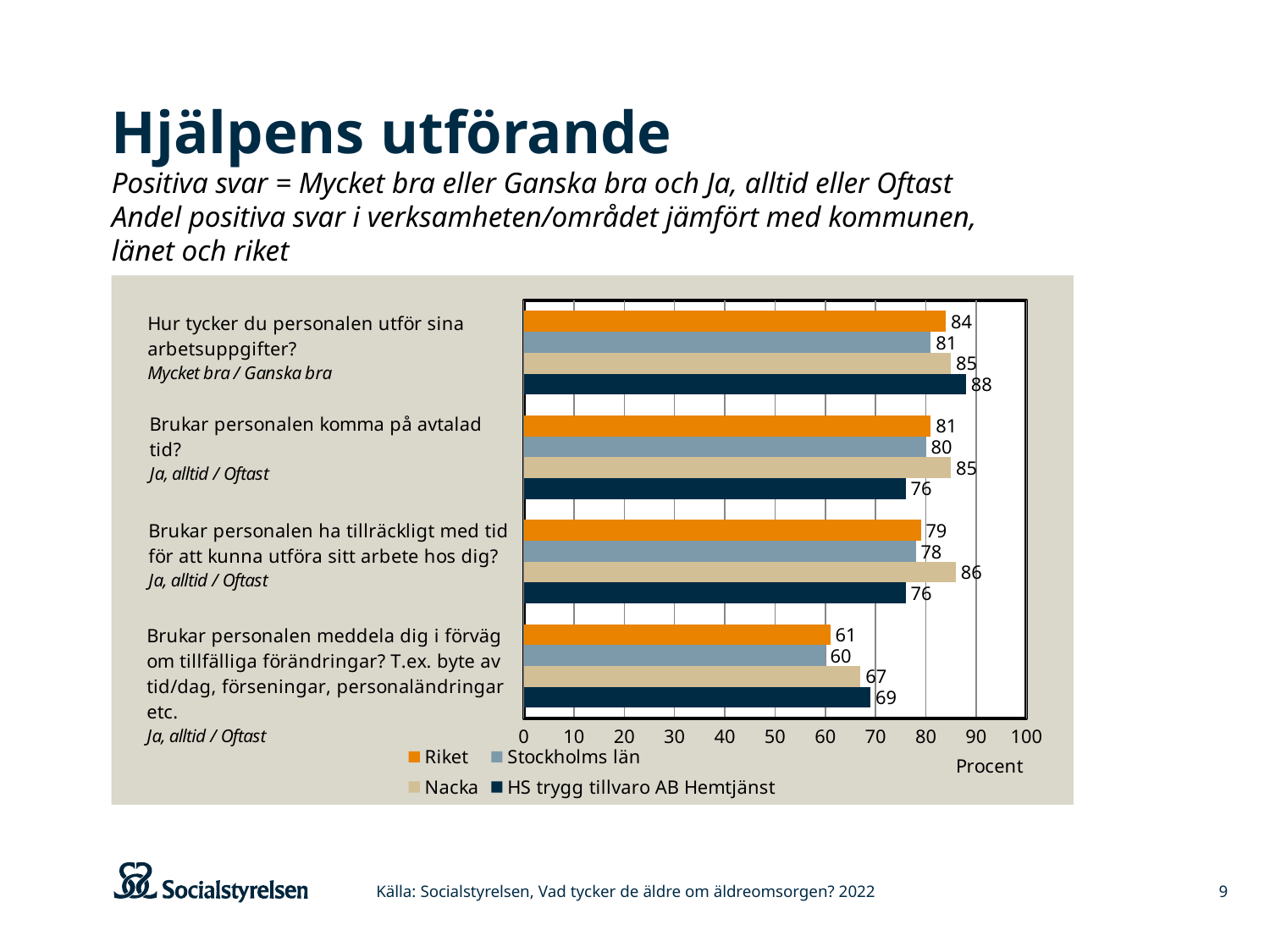
Which series has the highest value on the question "Hur tycker du personalen utför sina arbetsuppgifter?"? HS trygg tillvaro AB Hemtjänst What is the value for Stockholms län on the question "Brukar personalen meddela dig i förväg om tillfälliga förändringar?"? 60 What is the value for Riket on the question "Hur tycker du personalen utför sina arbetsuppgifter?"? 84 How many series does the legend list? 4 What is the difference between Nacka and HS trygg tillvaro AB Hemtjänst on the question "Brukar personalen komma på avtalad tid?"? 9 How many question categories are shown in the chart? 4 What kind of chart is shown on the slide? Bar chart Which is larger on the question "Brukar personalen ha tillräckligt med tid för att kunna utföra sitt arbete hos dig?": Riket or HS trygg tillvaro AB Hemtjänst? Riket What is the value for HS trygg tillvaro AB Hemtjänst on the question "Brukar personalen komma på avtalad tid?"? 76 What is the label of the x axis? Procent Which series has the lowest value on the question "Brukar personalen meddela dig i förväg om tillfälliga förändringar?"? Stockholms län What is the value for Nacka on the question "Brukar personalen ha tillräckligt med tid för att kunna utföra sitt arbete hos dig?"? 86